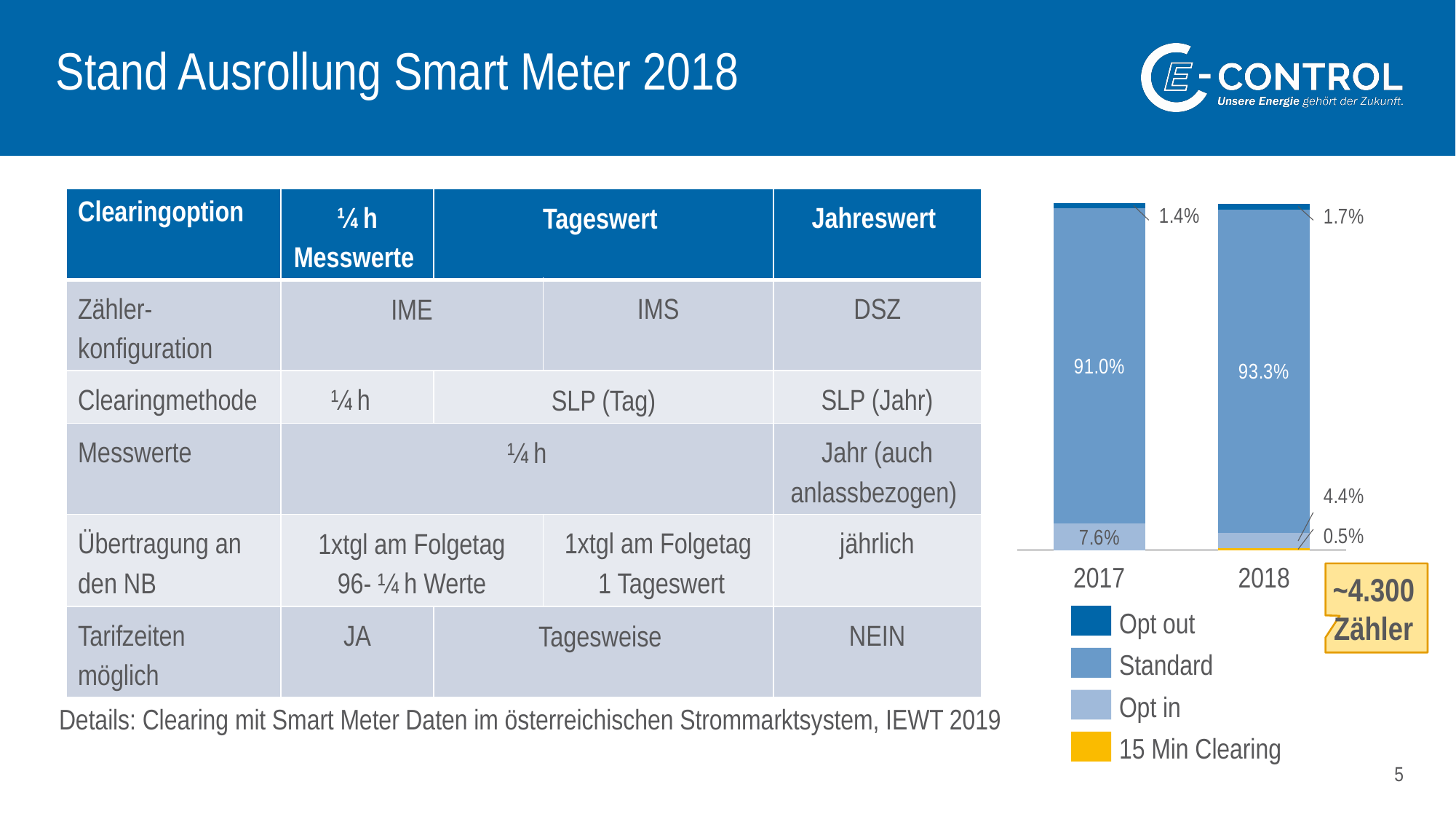
What is the Standard share for 2018 in the stacked bar chart? 93.3% Which series has the largest share in the 2018 bar? Standard How many series does the chart legend list? 4 Which series has the smallest share in the 2018 bar? 15 Min Clearing Is the Opt in share larger in 2017 or in 2018? 2017 How many years (bars) are shown in the chart? 2 What type of chart is shown on the right of the slide? Stacked bar chart What is the 15 Min Clearing share for 2018? 0.5% What is the Standard share for 2017 in the stacked bar chart? 91.0% What is the Opt in share for 2017? 7.6% What is the Opt out share for 2018? 1.7% By how many percentage points did the Standard share change from 2017 to 2018? 2.3 percentage points